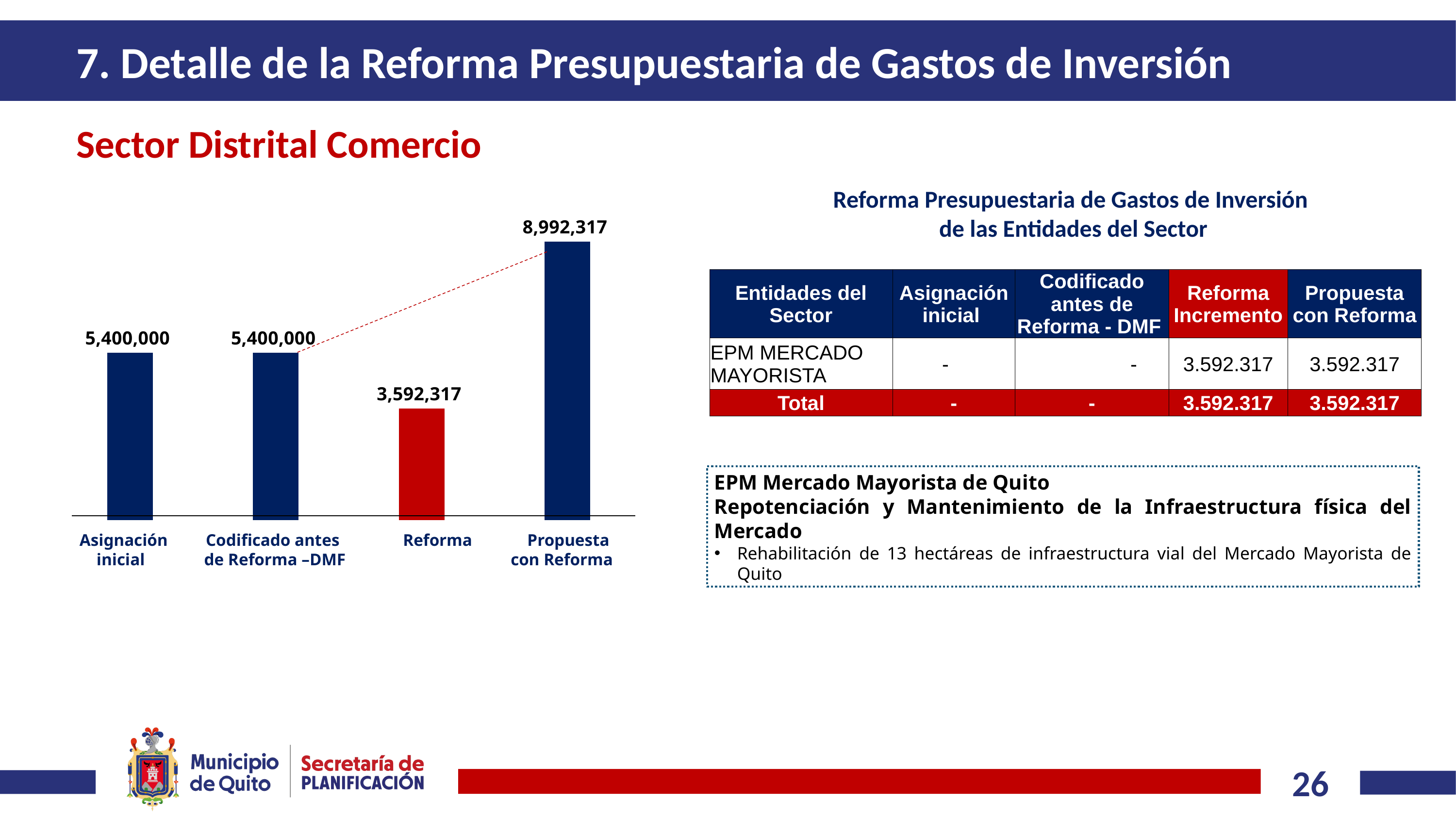
Which category has the highest value in the chart? Propuesta con Reforma What is the difference between the Propuesta con Reforma bar and the Codificado antes de Reforma –DMF bar? 3,592,317 What is the difference between the Propuesta con Reforma bar and the Reforma bar? 5,400,000 What colour is the Reforma bar? Red What is the value of the Reforma bar? 3,592,317 How many bars are shown in the chart? 4 Which category has the lowest value in the chart? Reforma What is the value of the Asignación inicial bar? 5,400,000 What type of chart is shown on the slide? Bar chart What is the value of the Codificado antes de Reforma –DMF bar? 5,400,000 What is the value of the Propuesta con Reforma bar? 8,992,317 Which is larger, the Reforma bar or the Asignación inicial bar? Asignación inicial